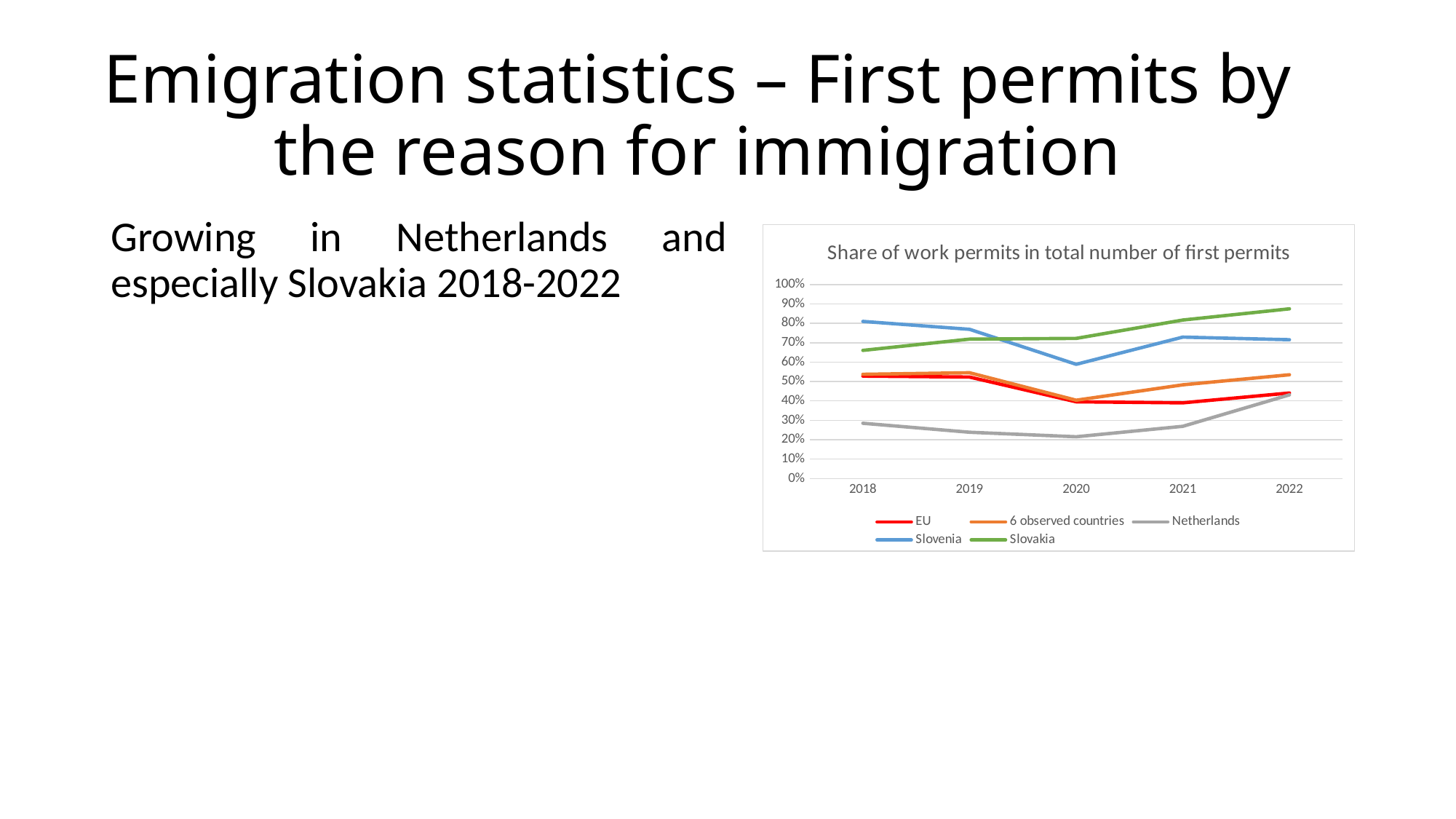
Is the value for Netherlands in 2020 greater or less than 30%? less Which series has the lowest share of work permits in 2018? Netherlands In which year does the Slovenia line reach its lowest value? 2020 Does the Slovakia line rise or fall from 2018 to 2022? rise Is the value for Slovenia in 2018 greater or less than 70%? greater What is the title of the chart? Share of work permits in total number of first permits Does the Netherlands line rise or fall from 2018 to 2020? fall Which series has the highest share of work permits in 2022? Slovakia How many series does the legend of the chart list? 5 In 2018, which is larger: the value for Slovenia or the value for Slovakia? Slovenia How many years are shown on the x axis of the chart? 5 What kind of chart is shown on the slide? line chart